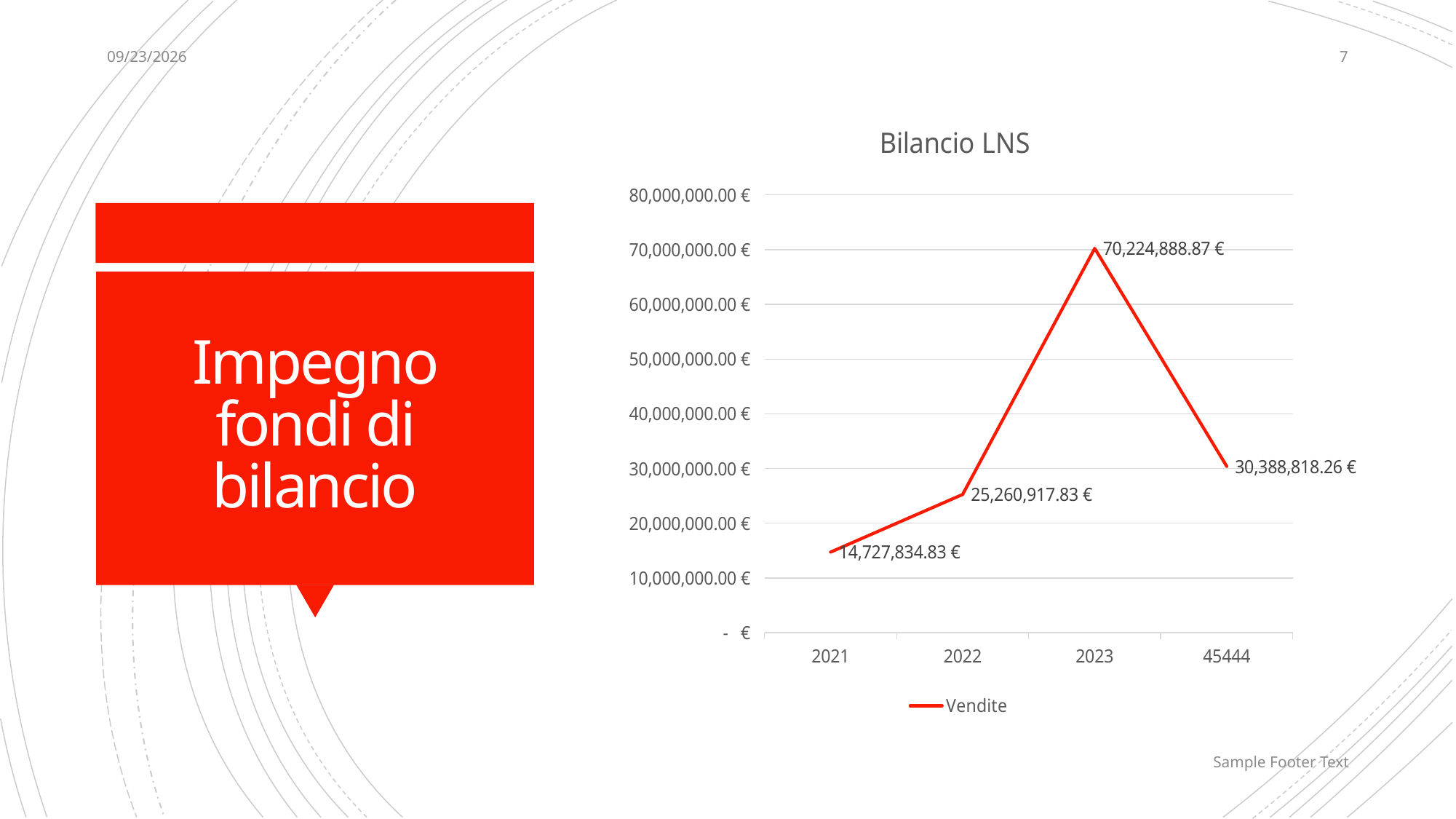
What is the value for 2022? 25,260,917.83 € Which category has the lowest value? 2021 What is the title of the chart? Bilancio LNS What type of chart is shown on the slide? line chart What series name does the legend show? Vendite What is the difference between the values for 2023 and 2022? 44,963,971.04 € What is the value for the category labelled 45444? 30,388,818.26 € What is the value for 2023? 70,224,888.87 € What is the value for 2021? 14,727,834.83 € Which category has the highest value? 2023 How many data points are plotted on the chart? 4 Which is larger, the value for 2022 or the value for 45444? 45444